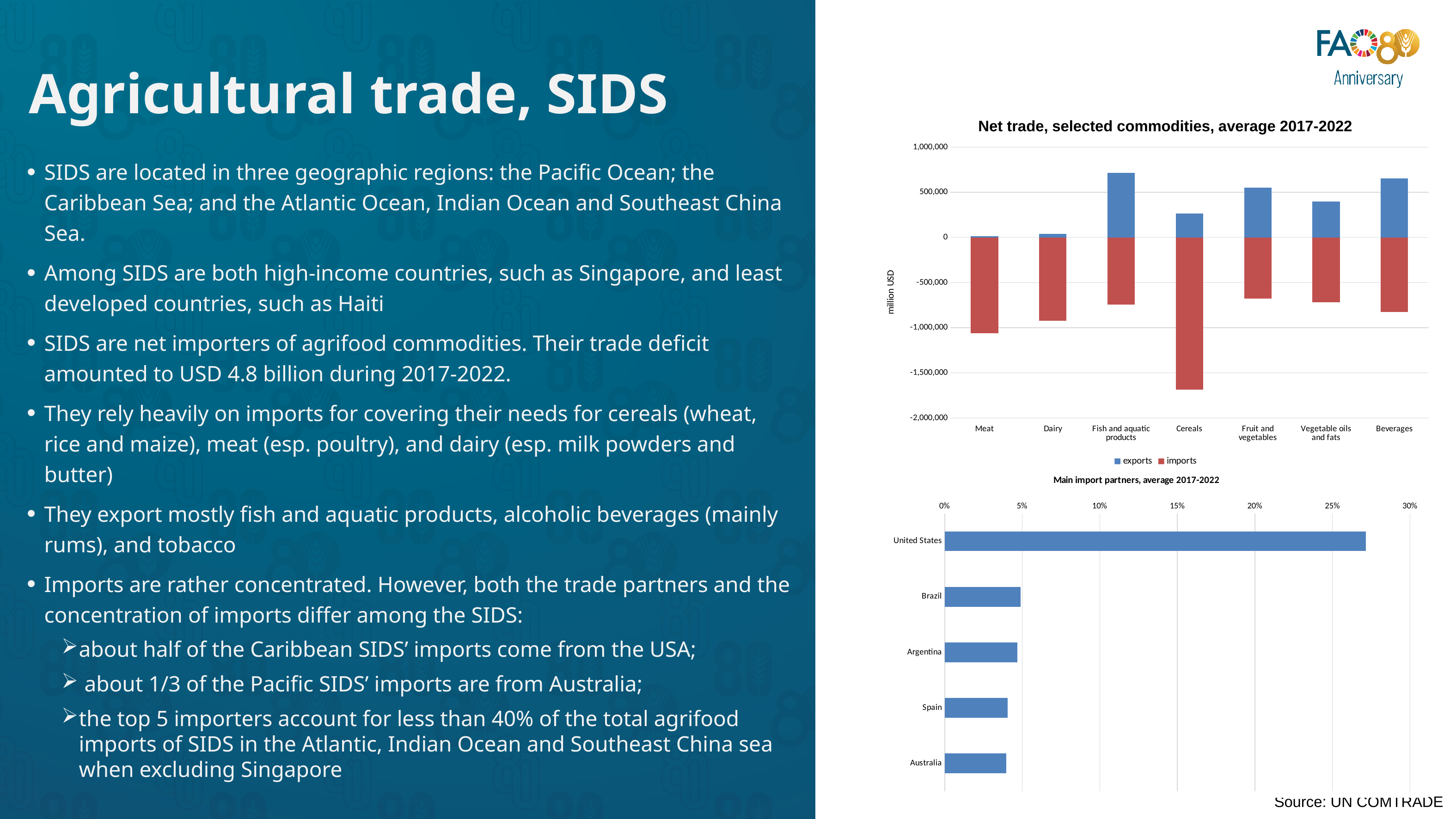
In the 'Net trade, selected commodities, average 2017-2022' chart, is the exports value for Fish and aquatic products greater or less than 500,000? greater What is the y-axis label of the 'Net trade, selected commodities, average 2017-2022' chart? million USD How many commodity categories are shown in the 'Net trade, selected commodities, average 2017-2022' chart? 7 How many series does the legend of the 'Net trade, selected commodities, average 2017-2022' chart list? 2 How many import partners are shown in the 'Main import partners, average 2017-2022' chart? 5 In the 'Net trade, selected commodities, average 2017-2022' chart, which commodity has the largest imports bar (most negative value)? Cereals In the 'Main import partners, average 2017-2022' chart, which partner has the highest share? United States In the 'Net trade, selected commodities, average 2017-2022' chart, is the imports value for Cereals greater or less than -1,500,000? less What kind of chart is 'Net trade, selected commodities, average 2017-2022'? bar chart In the 'Net trade, selected commodities, average 2017-2022' chart, are exports for Beverages larger or smaller than exports for Vegetable oils and fats? larger In the 'Net trade, selected commodities, average 2017-2022' chart, which commodity has the smallest exports value? Meat In the 'Main import partners, average 2017-2022' chart, is the value for United States greater or less than 25%? greater